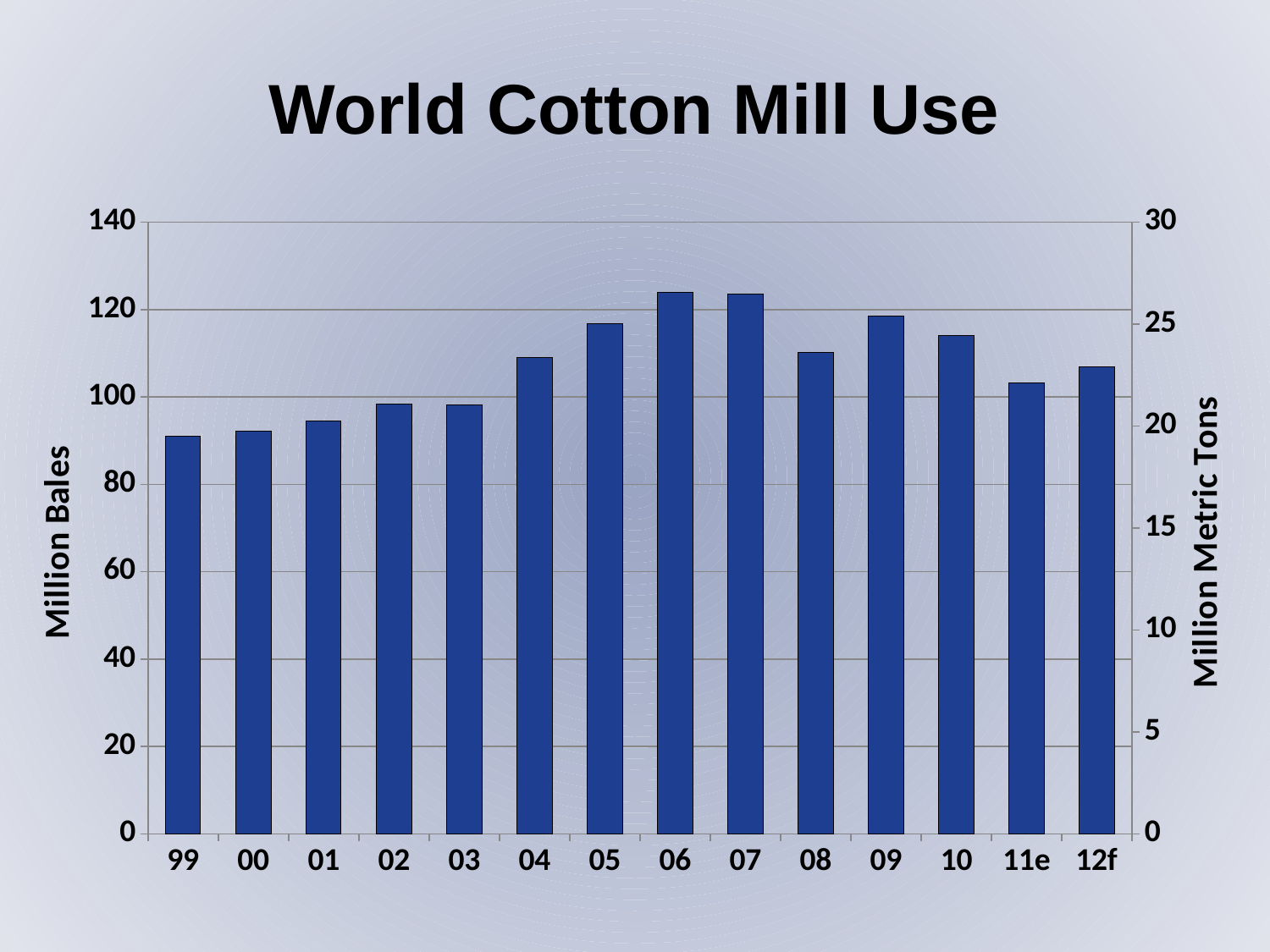
Is the value for 06 greater or less than 120 million bales? greater Is the value for 12f greater or less than 100 million bales? greater Is the value for 99 greater or less than 100 million bales? less Do the values rise or fall from 99 to 06? rise Which year has the larger value, 11e or 12f? 12f What kind of chart is shown on the slide? bar chart Which year has the larger value, 09 or 08? 09 Which year has the larger value, 06 or 99? 06 How many years (categories) are plotted on the x axis? 14 What is the label of the right-hand vertical axis? Million Metric Tons